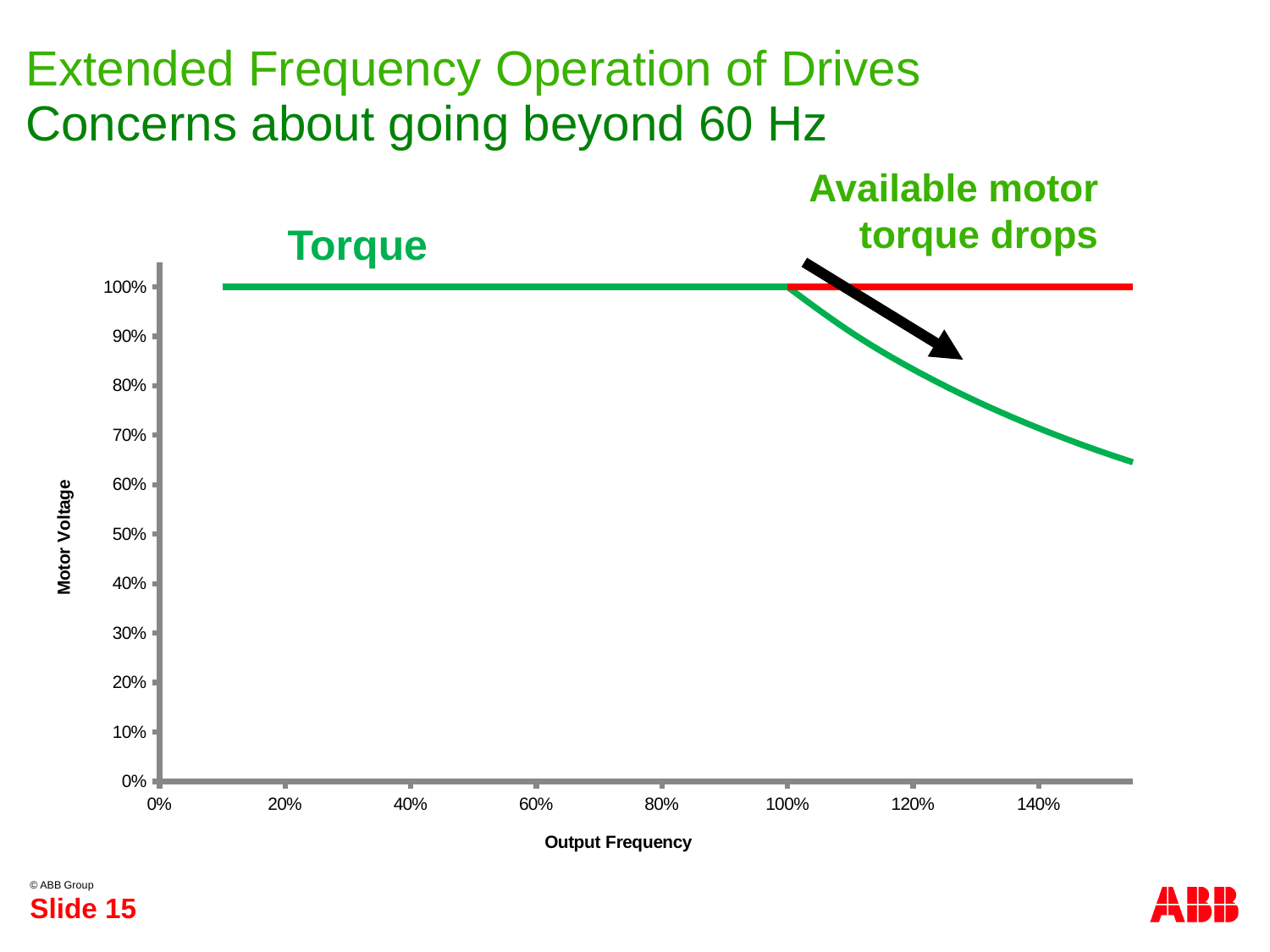
Is the value of the green line at 140% output frequency greater or less than 60%? greater What is the motor voltage shown by the green line at 60% output frequency? 100% Does the green line rise, fall or stay flat between 20% and 100% output frequency? stay flat What is the motor voltage shown by the green line at 100% output frequency? 100% Does the green line rise, fall or stay flat as output frequency increases beyond 100%? fall What is the label of the horizontal axis? Output Frequency Is the value of the green line at 120% output frequency greater or less than 70%? greater At 140% output frequency, which line shows the higher value, the red line or the green line? red line Is the value of the green line at 140% output frequency greater or less than 80%? less What is the label of the vertical axis? Motor Voltage What kind of chart is shown on the slide? line chart What value does the red line show at 120% output frequency? 100%